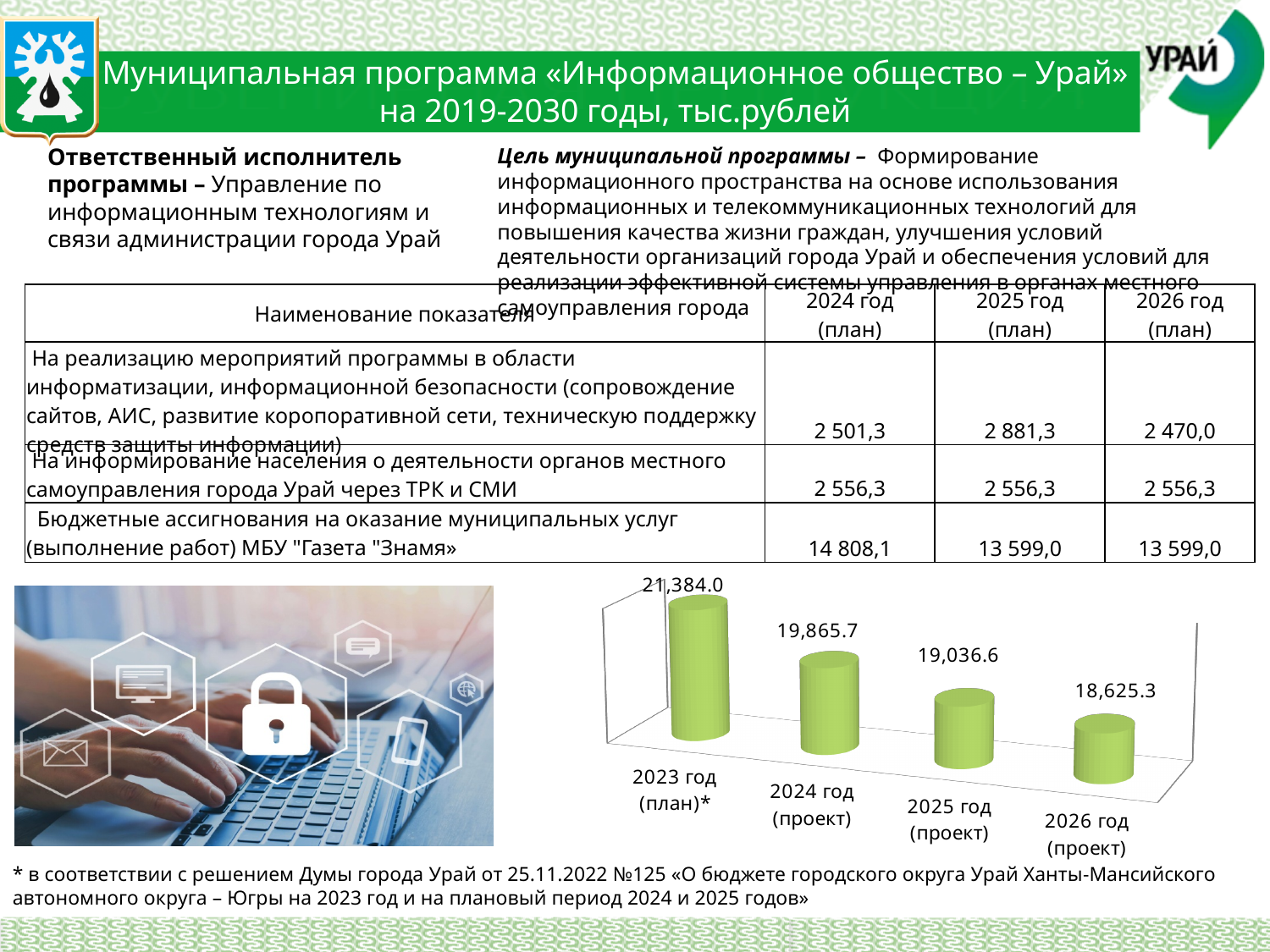
What is the difference between the values for 2025 год (проект) and 2026 год (проект)? 411.3 What is the value shown for 2024 год (проект) in the chart? 19,865.7 Which is larger: the value for 2024 год (проект) or the value for 2025 год (проект)? 2024 год (проект) What is the value shown for 2025 год (проект) in the chart? 19,036.6 What is the difference between the values for 2023 год (план)* and 2024 год (проект)? 1,518.3 Which year has the lowest value in the chart? 2026 год (проект) Do the values in the chart rise or fall from 2023 to 2026? Fall What kind of chart is shown on the slide? Bar chart What is the value shown for 2026 год (проект) in the chart? 18,625.3 How many years (categories) are plotted in the chart? 4 Which year has the highest value in the chart? 2023 год (план)* What is the value shown for 2023 год (план)* in the chart? 21,384.0